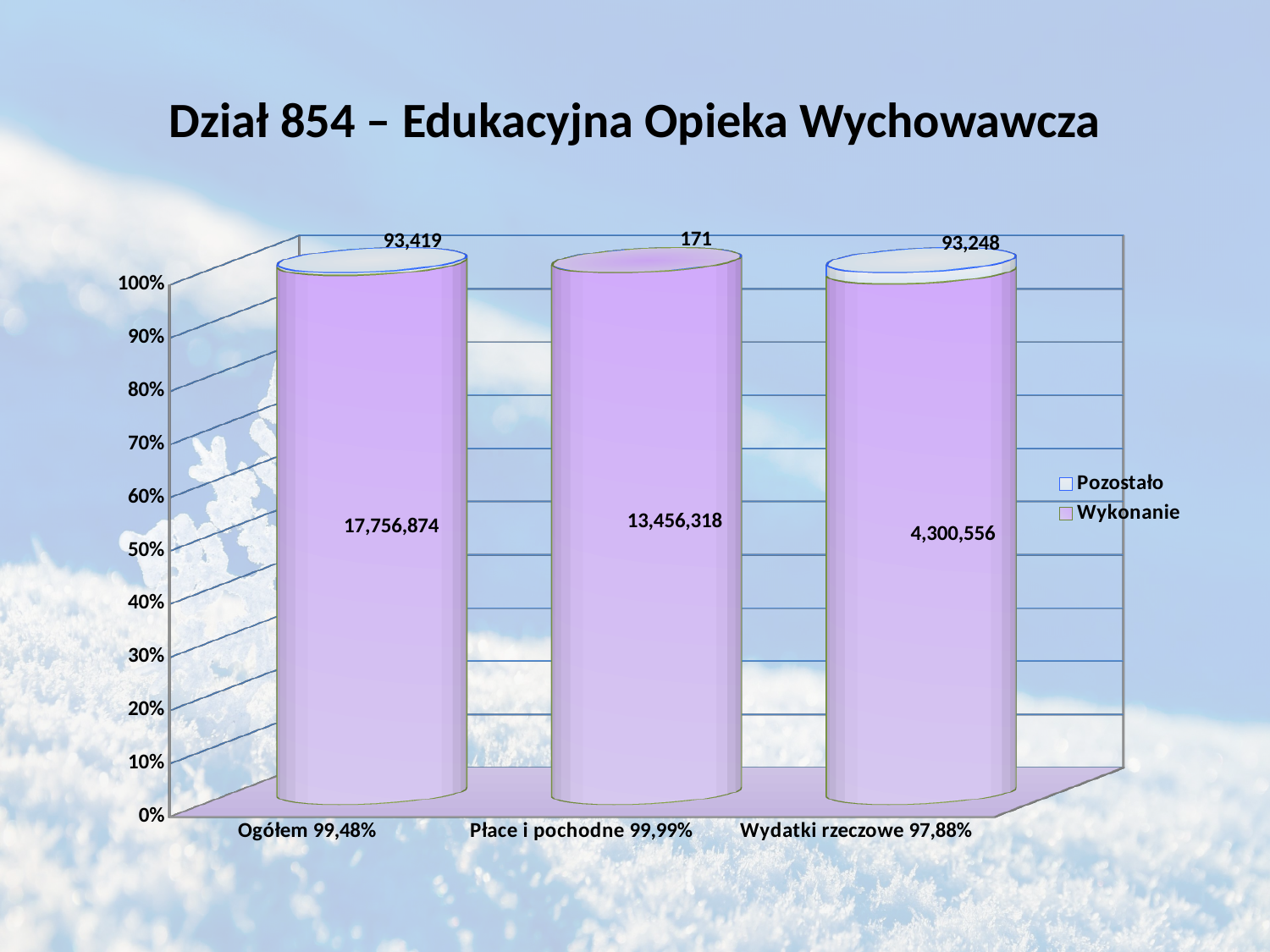
What is the difference between the Wykonanie values for Ogółem 99,48% and Płace i pochodne 99,99%? 4,300,556 Which is larger, the Pozostało value for Ogółem 99,48% or for Wydatki rzeczowe 97,88%? Ogółem 99,48% What is the Wykonanie value for Wydatki rzeczowe 97,88%? 4,300,556 What is the Wykonanie value for Ogółem 99,48%? 17,756,874 What is the title of the slide? Dział 854 – Edukacyjna Opieka Wychowawcza How many series does the legend list? 2 Which category has the highest Wykonanie value? Ogółem 99,48% What is the Pozostało value for Wydatki rzeczowe 97,88%? 93,248 What is the Pozostało value for Płace i pochodne 99,99%? 171 What kind of chart is shown on the slide? Stacked bar chart How many categories are shown on the x axis? 3 Which category has the lowest Pozostało value? Płace i pochodne 99,99%